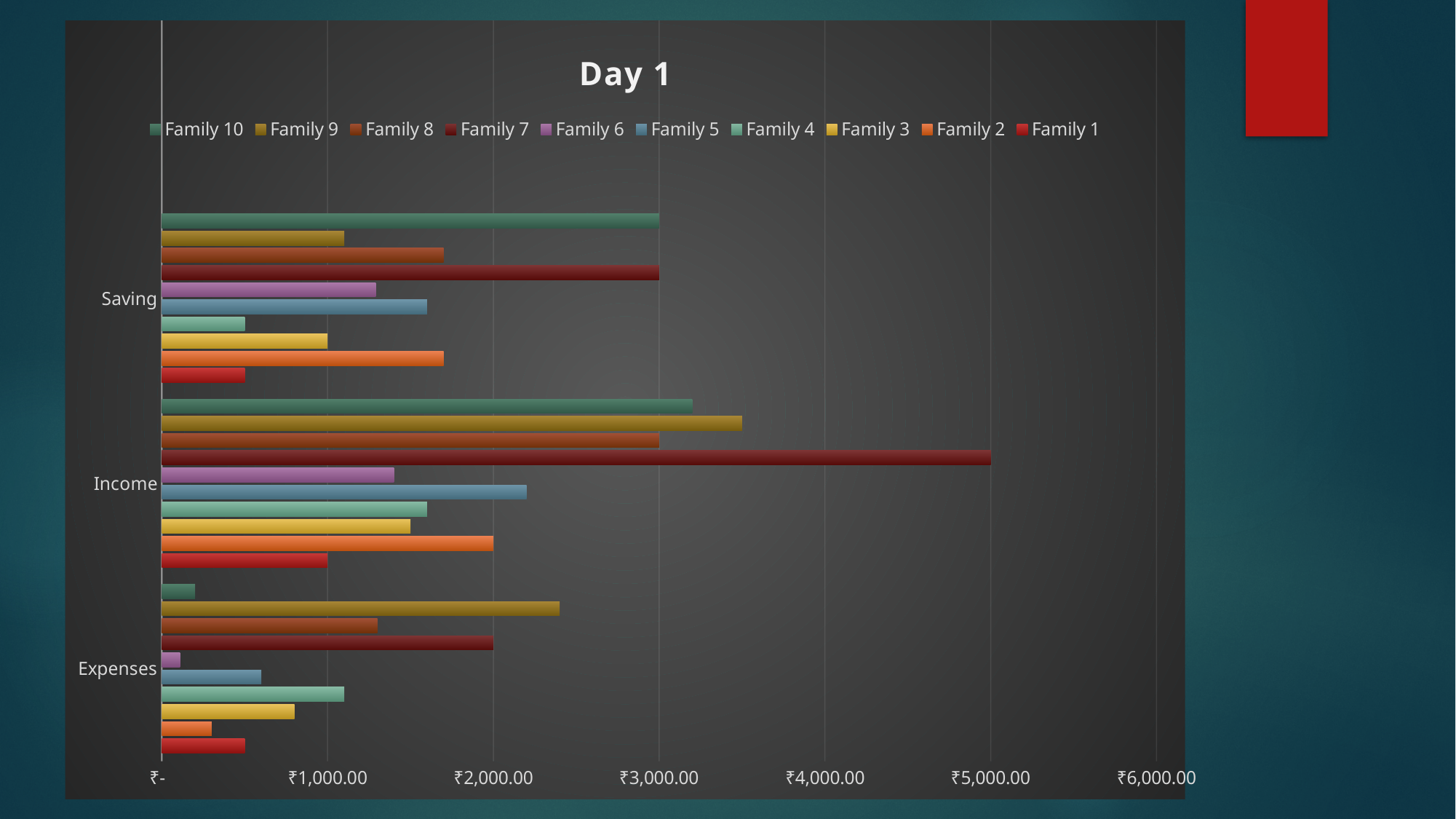
Which is larger: the Saving value for Family 10 or for Family 9? Family 10 What is the title of the chart? Day 1 Is the Saving value for Family 4 greater or less than ₹1,000.00? less How many series does the legend list? 10 Which is larger: the Expenses value for Family 9 or for Family 1? Family 9 Which family has the highest Income? Family 7 How many categories are shown on the vertical axis? 3 What kind of chart is shown on the slide? bar chart Is the Income value for Family 9 greater or less than ₹3,000.00? greater Is the Expenses value for Family 10 greater or less than ₹1,000.00? less What is the Income value for Family 7? ₹5,000.00 Which family has the lowest Expenses? Family 6